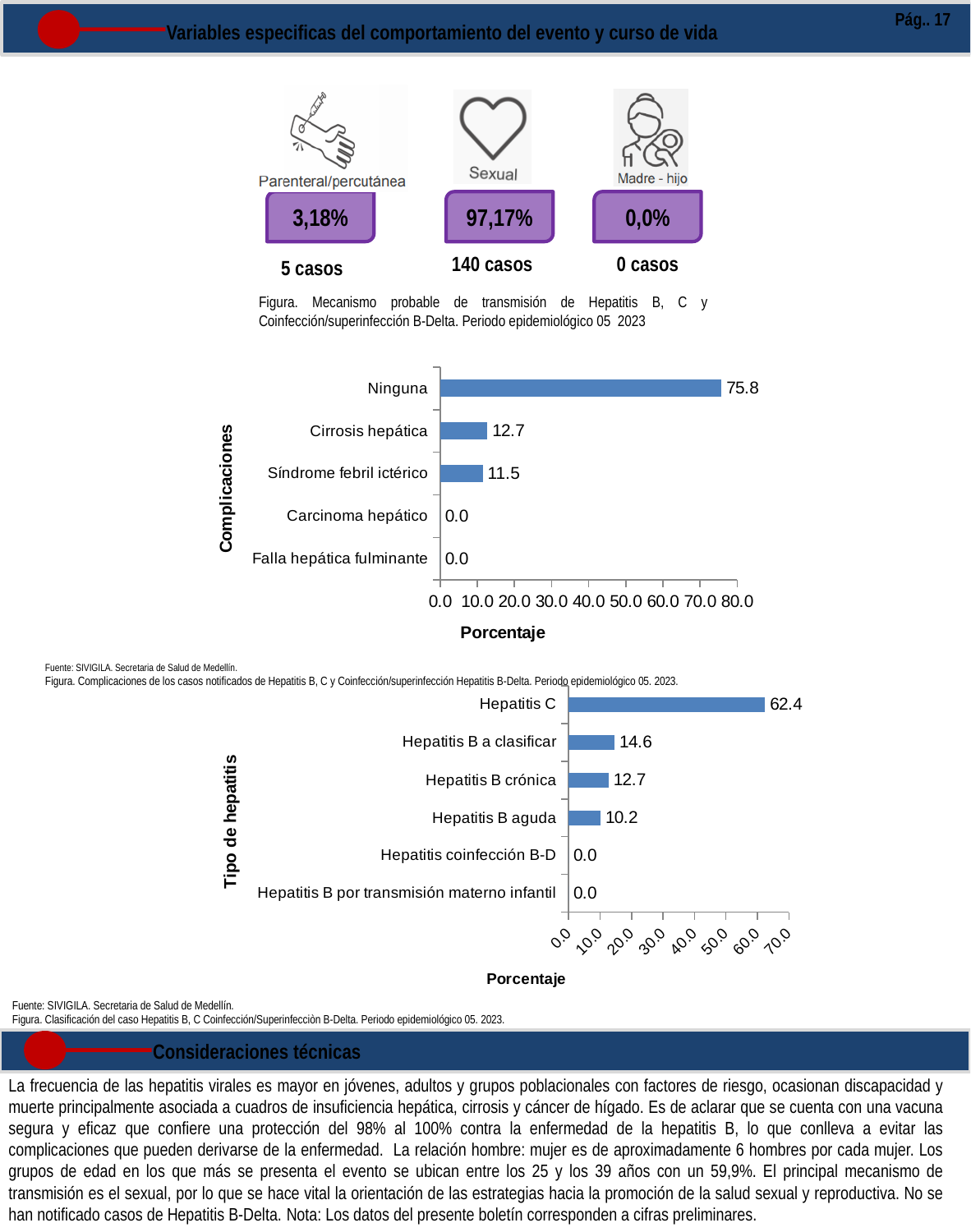
What type of chart is the lower chart (Tipo de hepatitis)? Bar chart In the lower chart (Tipo de hepatitis), what is the difference between Hepatitis C and Hepatitis B a clasificar? 47.8 In the lower chart (Tipo de hepatitis), what is the value for Hepatitis C? 62.4 In the upper chart (Complicaciones), what is the difference between Cirrosis hepática and Síndrome febril ictérico? 1.2 In the upper chart (Complicaciones), what is the label of the horizontal axis? Porcentaje In the lower chart (Tipo de hepatitis), what is the value for Hepatitis B aguda? 10.2 In the upper chart (Complicaciones), what is the value for Síndrome febril ictérico? 11.5 In the upper chart (Complicaciones), how many categories are shown on the vertical axis? 5 In the lower chart (Tipo de hepatitis), which is larger, Hepatitis B a clasificar or Hepatitis B crónica? Hepatitis B a clasificar In the lower chart (Tipo de hepatitis), how many categories are shown on the vertical axis? 6 In the upper chart (Complicaciones), which category has the highest value? Ninguna In the upper chart (Complicaciones), what is the value for Ninguna? 75.8